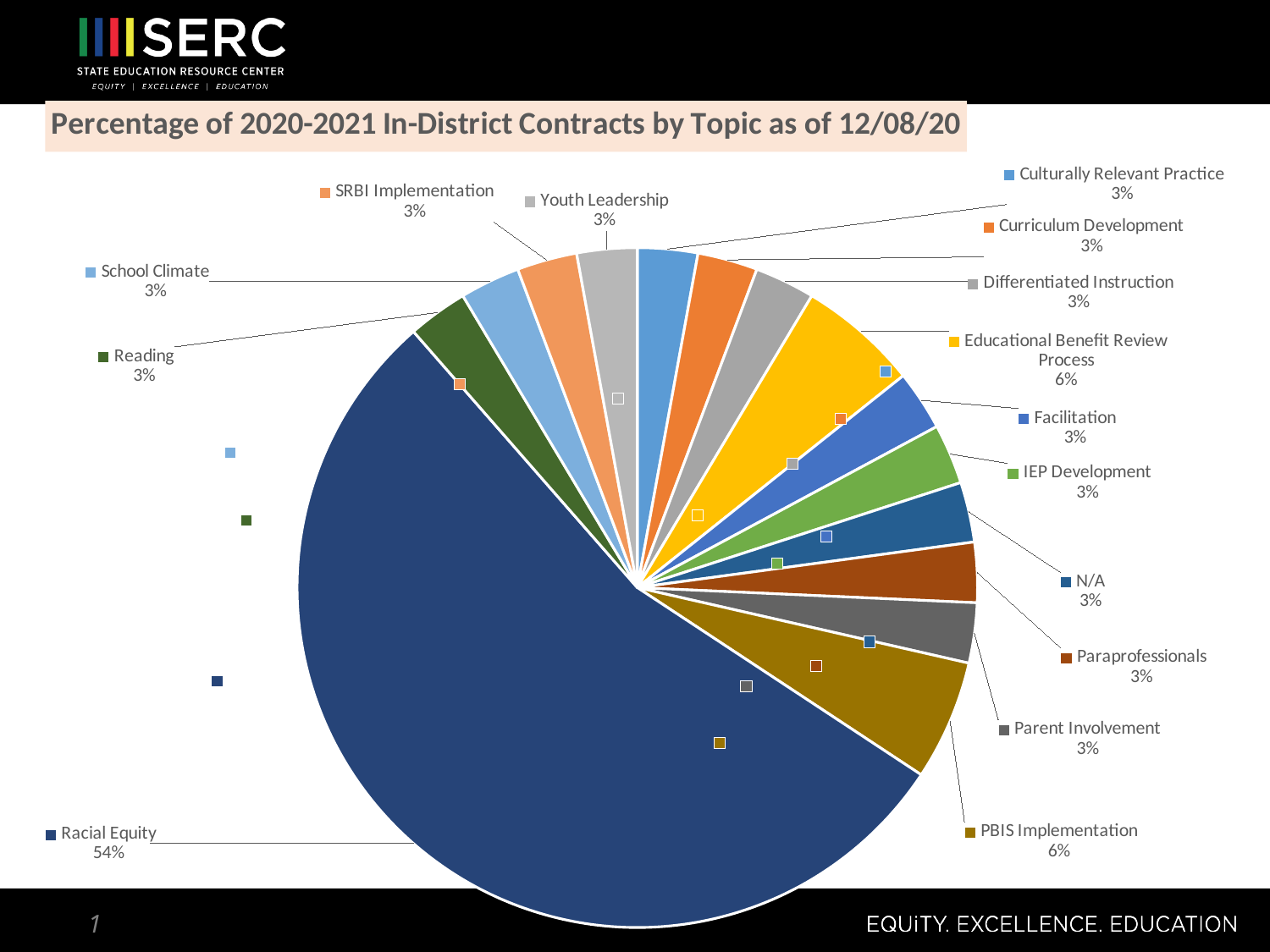
What is the difference between the share for Racial Equity and the share for PBIS Implementation? 48% How many topic categories are shown in the pie chart? 15 What is the title of the chart? Percentage of 2020-2021 In-District Contracts by Topic as of 12/08/20 What percentage of in-district contracts is for Paraprofessionals? 3% What is the combined share of PBIS Implementation and Educational Benefit Review Process? 12% Which is larger, the share for Educational Benefit Review Process or the share for Facilitation? Educational Benefit Review Process What share of the pie does Youth Leadership represent? 3% What kind of chart is shown on the slide? pie chart What percentage of in-district contracts is for PBIS Implementation? 6% Which topic has the largest share of in-district contracts? Racial Equity What percentage of in-district contracts is for Educational Benefit Review Process? 6% What percentage of in-district contracts is for Racial Equity? 54%